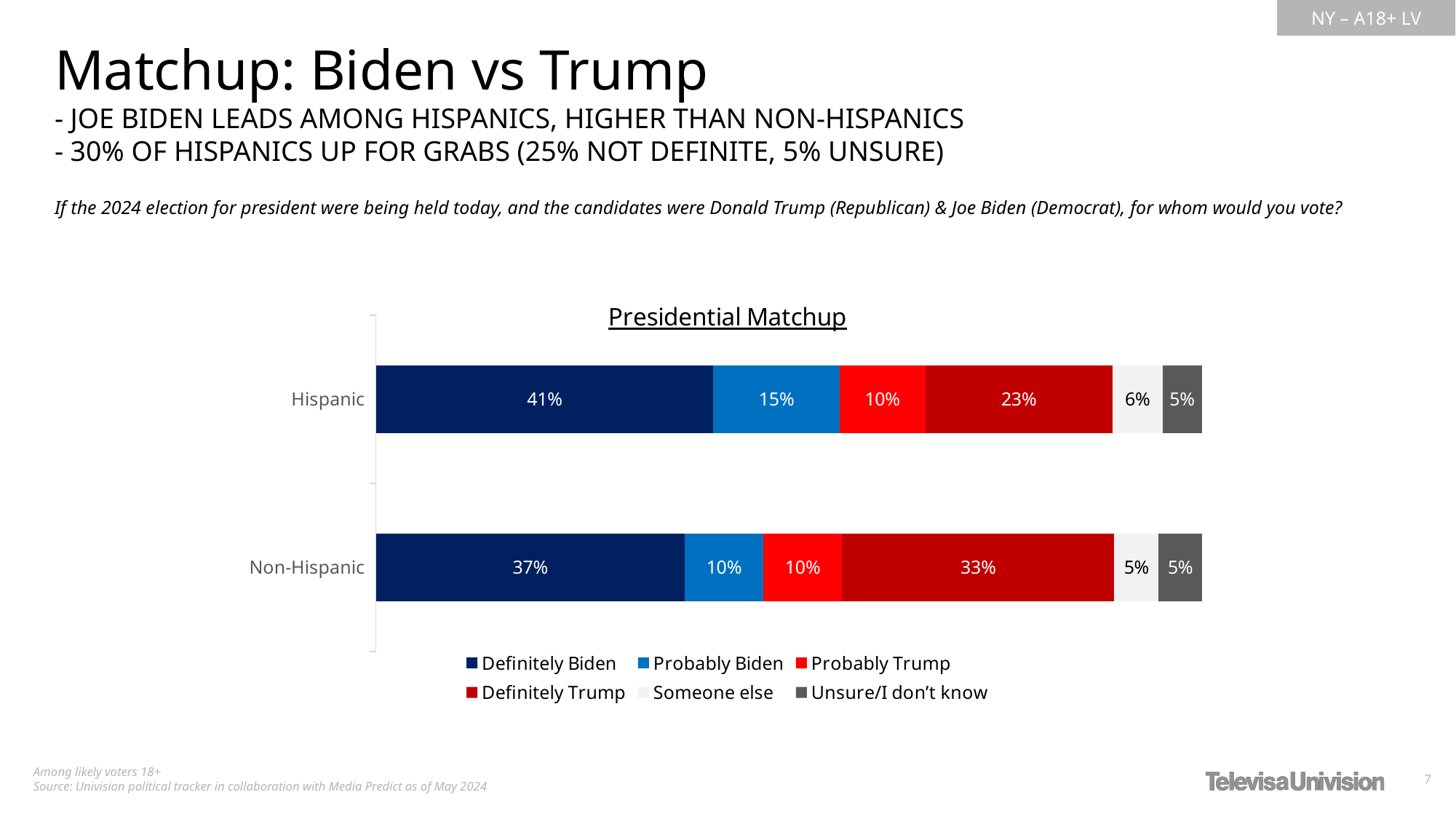
What is the Probably Biden value for Non-Hispanic respondents? 10% Which series has the largest value in the Hispanic bar? Definitely Biden What type of chart is shown on the slide? Stacked bar chart What is the difference between the Definitely Trump values for Non-Hispanic and Hispanic respondents? 10% Which category has the higher Definitely Biden value, Hispanic or Non-Hispanic? Hispanic What percentage of Hispanic respondents said Definitely Biden? 41% How many categories are shown on the chart? 2 What is the total of the Hispanic stacked bar? 100% How many series does the legend list? 6 What percentage of Non-Hispanic respondents said Definitely Trump? 33% What is the difference between the Probably Biden values for Hispanic and Non-Hispanic respondents? 5% What is the Someone else value for Hispanic respondents? 6%